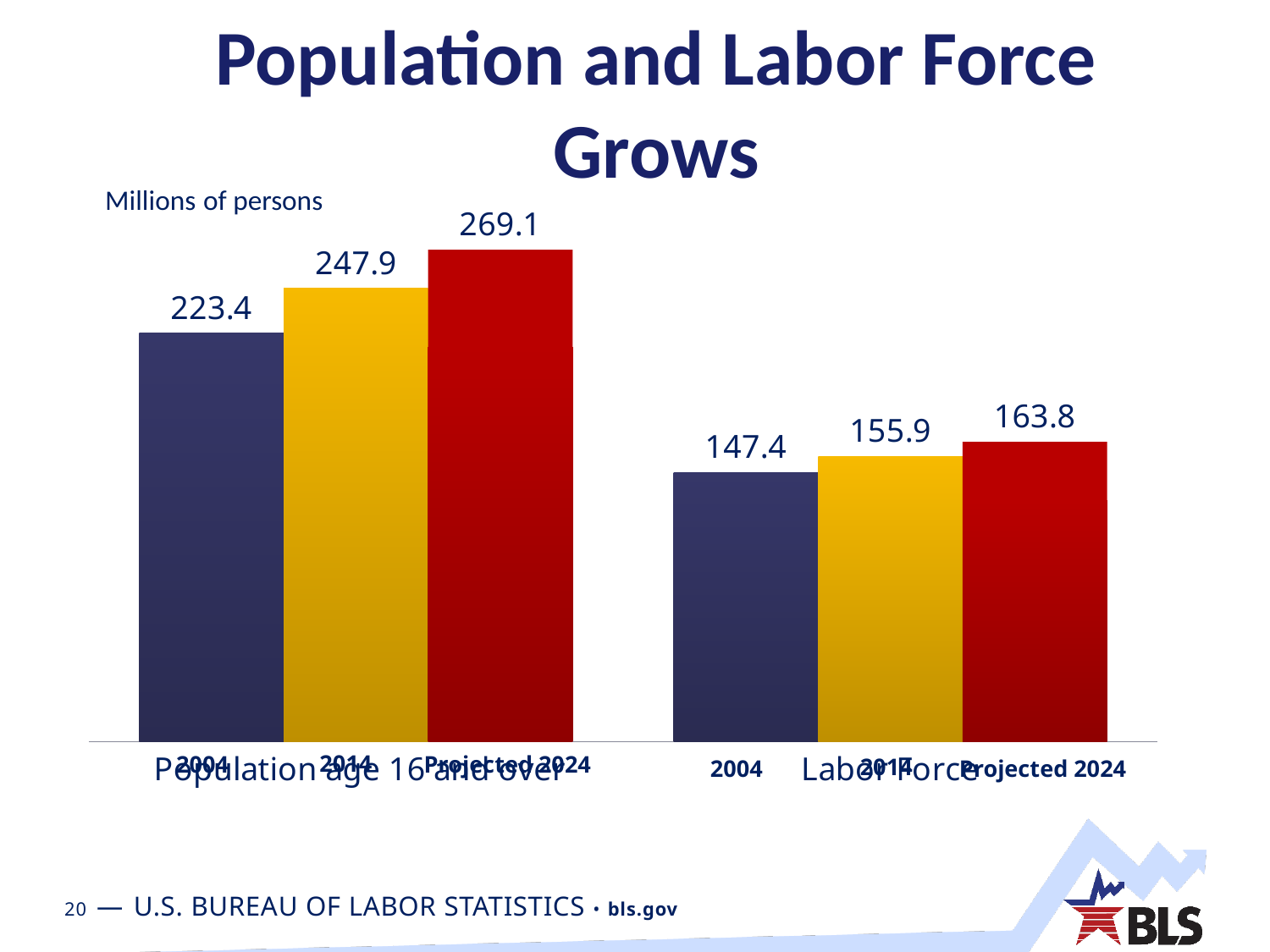
What is the difference between the Population age 16 and over values for Projected 2024 and 2004? 45.7 Which bar has the lowest value on the chart? Labor Force, 2004 What is the difference between the Labor Force values for 2014 and 2004? 8.5 What is the value for Labor Force in Projected 2024? 163.8 What is the value for Population age 16 and over in Projected 2024? 269.1 What is the value for Labor Force in 2014? 155.9 What is the value for Population age 16 and over in 2004? 223.4 Which is larger: Population age 16 and over in 2014 or Labor Force in Projected 2024? Population age 16 and over in 2014 Which bar has the highest value on the chart? Population age 16 and over, Projected 2024 What kind of chart is shown on the slide? bar chart Do the Labor Force values rise or fall from 2004 to Projected 2024? rise What unit is stated for the values on the chart? Millions of persons